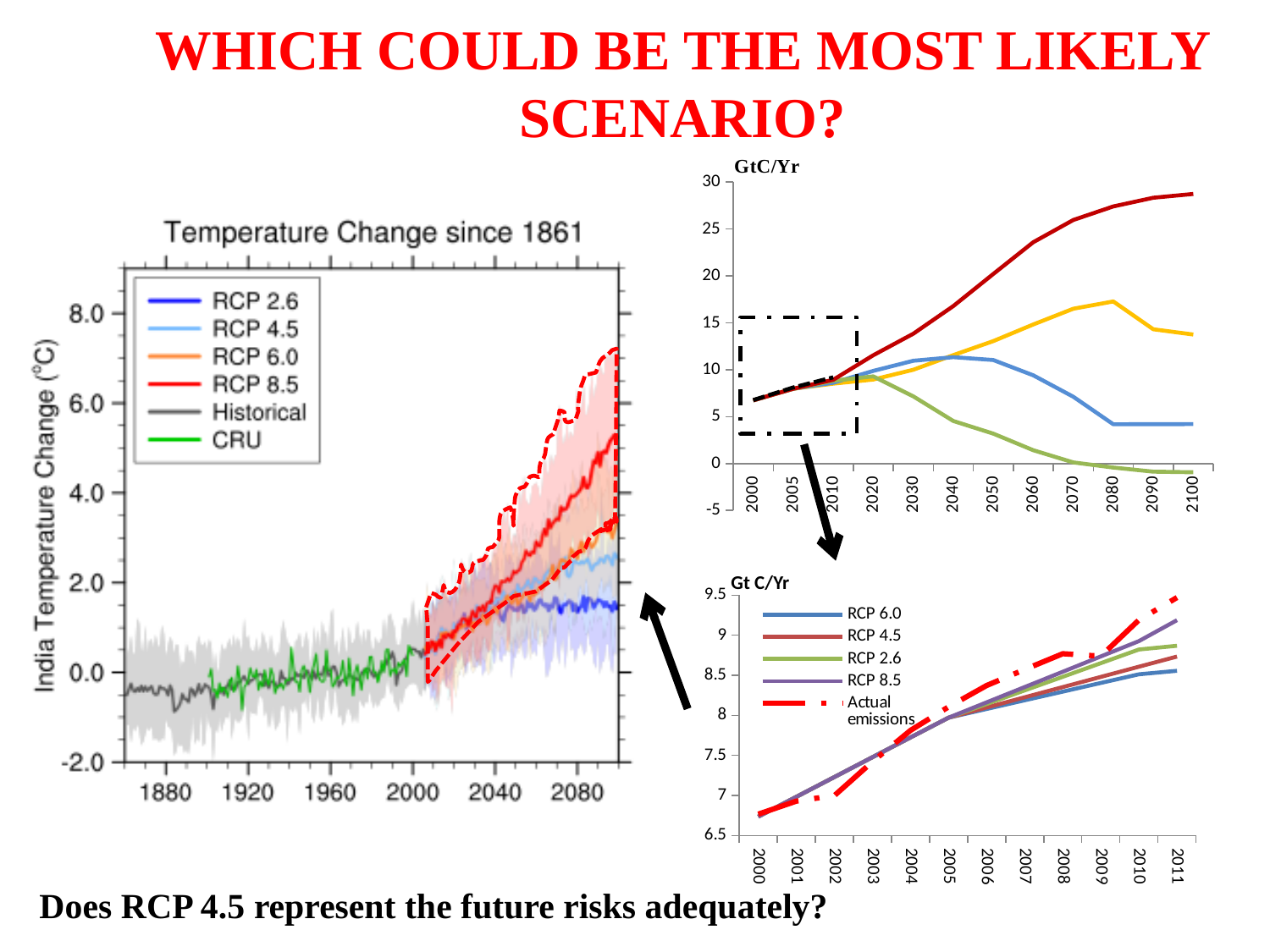
In the 'Temperature Change since 1861' chart, is the RCP 2.6 value at the end of the series greater or less than 2.0? less What is the y-axis label of the 'Temperature Change since 1861' chart? India Temperature Change (°C) In the bottom-right Gt C/Yr chart, which series has the highest value at 2011? Actual emissions What kind of chart is the 'Temperature Change since 1861' chart on the left? line chart In the 'Temperature Change since 1861' chart, is the RCP 8.5 value at the end of the series greater or less than 4.0? greater In the top-right GtC/Yr chart, is the dark red line's value at 2100 greater or less than 25? greater How many series does the legend of the bottom-right Gt C/Yr chart list? 5 In the top-right GtC/Yr chart, how many year ticks are shown on the x axis? 12 How many series does the legend of the 'Temperature Change since 1861' chart list? 6 In the 'Temperature Change since 1861' chart, which scenario has the highest temperature change at the end of the series (around 2100)? RCP 8.5